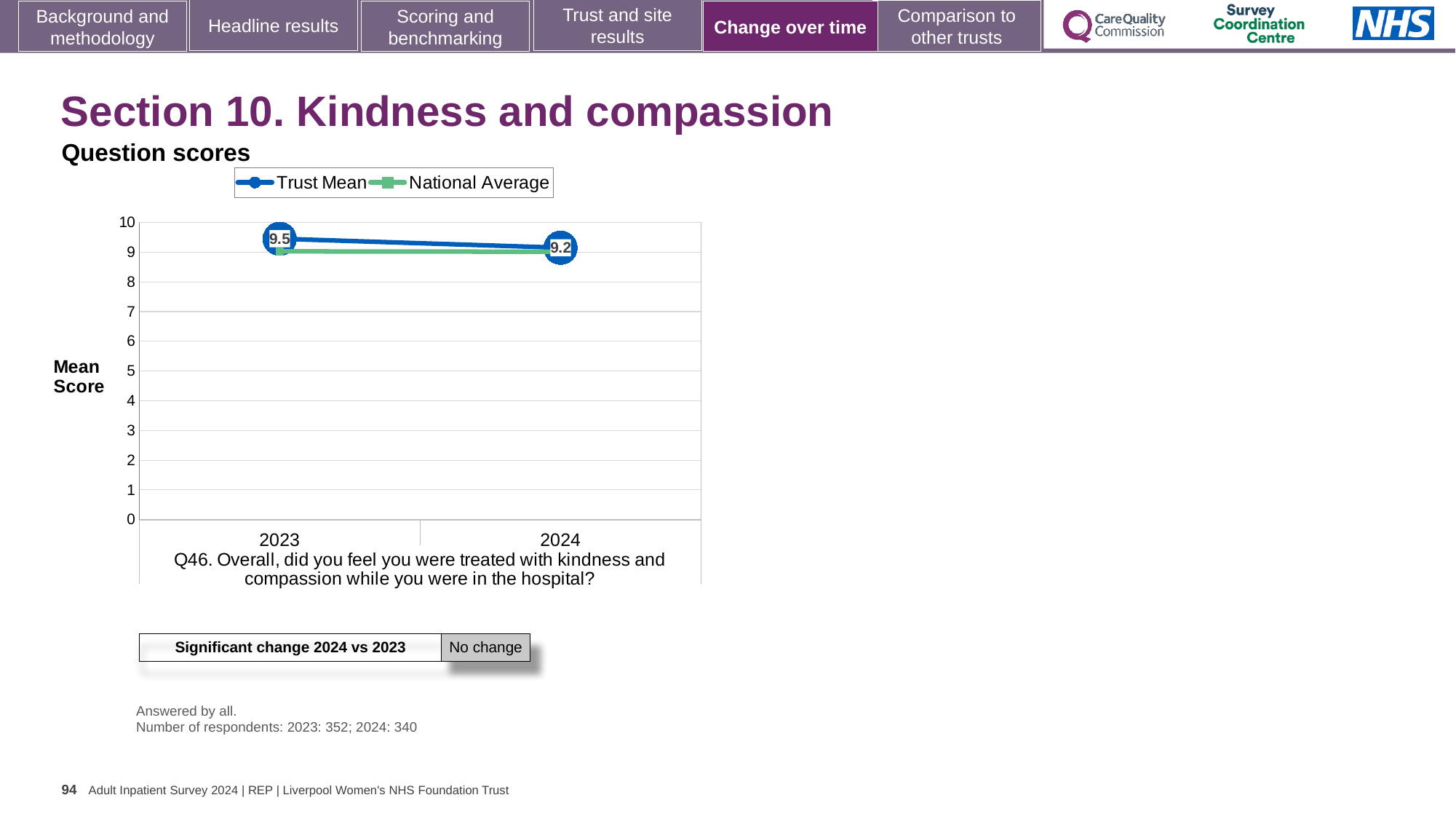
What is the label on the y axis of the chart? Mean Score In which year is the Trust Mean score highest? 2023 By how much did the Trust Mean score change from 2023 to 2024? 0.3 What is the Trust Mean score for 2023? 9.5 What kind of chart is shown on the slide? line chart What is the Trust Mean score for 2024? 9.2 How many years are plotted on the x axis? 2 How many series does the legend list? 2 Which year has the higher Trust Mean score, 2023 or 2024? 2023 Does the Trust Mean line rise or fall from 2023 to 2024? fall In 2023, which is higher, the Trust Mean or the National Average? Trust Mean Is the National Average value for 2023 greater or less than 5? greater